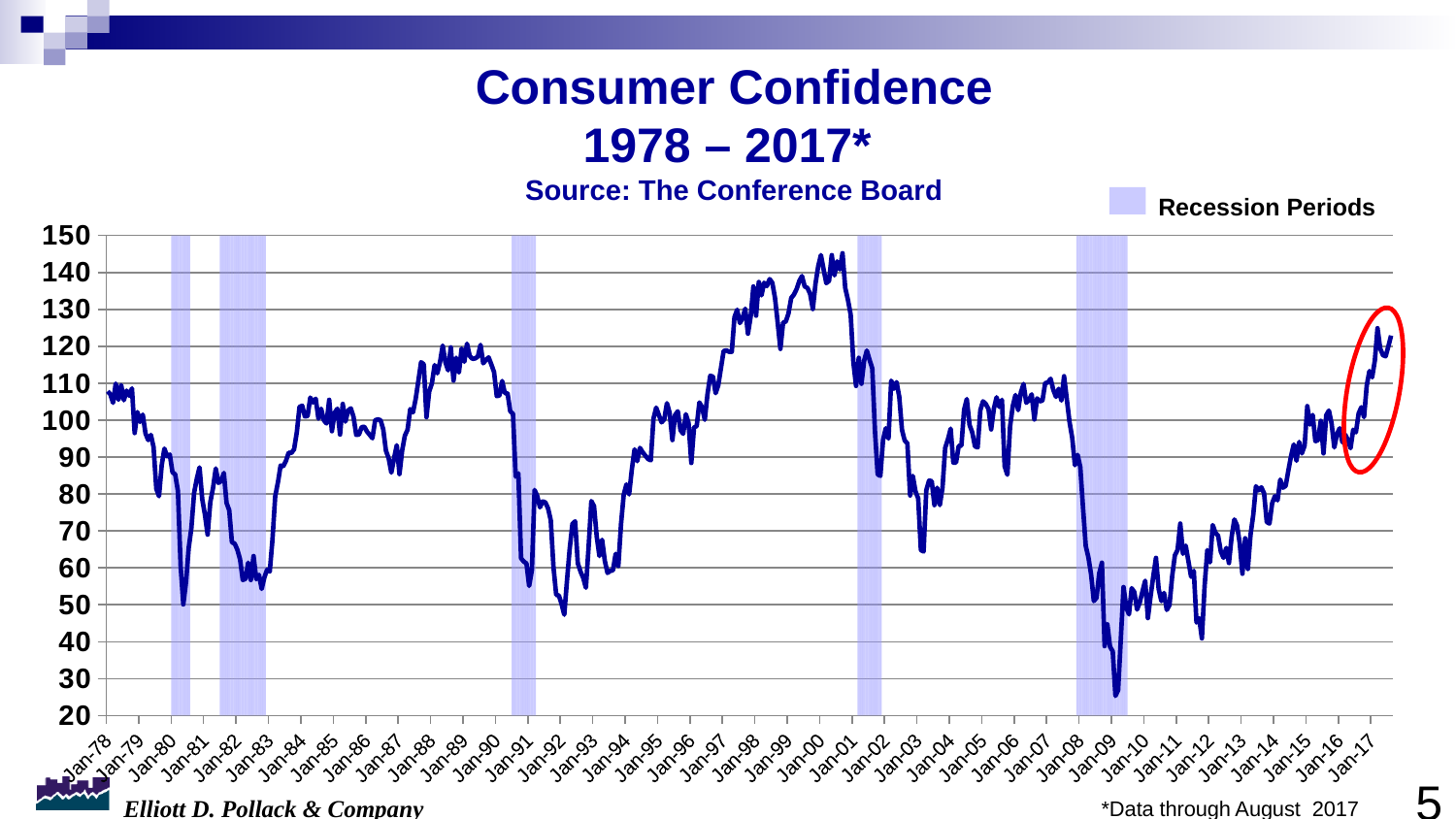
What does the shaded area in the legend represent? Recession Periods Is the peak consumer confidence value reached around 2000 greater or less than 140? greater Which is higher, consumer confidence at Jan-78 or at Jan-09? Jan-78 Is the lowest consumer confidence value reached in 2009 greater or less than 30? less Does consumer confidence generally rise or fall between Jan-00 and Jan-03? fall Around which year does consumer confidence reach its lowest value on the chart? 2009 What kind of chart is shown on the slide? Line chart Does consumer confidence generally rise or fall between Jan-09 and Jan-17? rise Around which year does consumer confidence reach its highest value on the chart? 2000 What is the title of the chart? Consumer Confidence 1978 – 2017* Is the consumer confidence value at Jan-78 greater or less than 100? greater